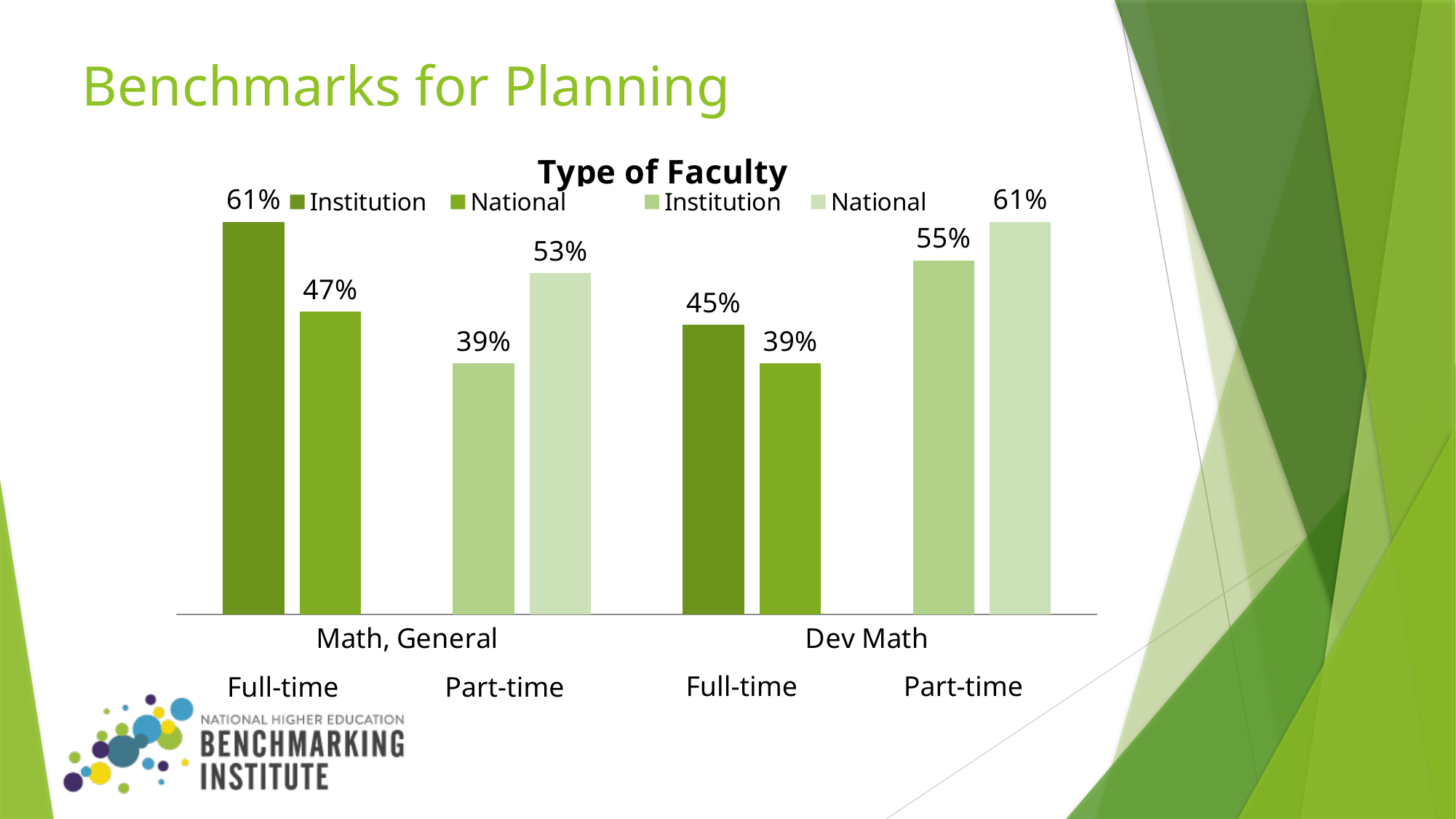
How many entries does the legend list? 4 What is the Part-time National value for Dev Math? 61% What kind of chart is shown on the slide? bar chart Which bar is the lowest for Math, General? Part-time Institution (39%) How many course categories are shown on the x axis? 2 What is the title of the chart? Type of Faculty Which is larger for Dev Math: the Part-time Institution value or the Part-time National value? Part-time National What is the difference between the Full-time Institution and Full-time National values for Math, General? 14% What is the Full-time National value for Math, General? 47% What is the Full-time Institution value for Math, General? 61% What is the Full-time National value for Dev Math? 39% What is the Part-time Institution value for Dev Math? 55%